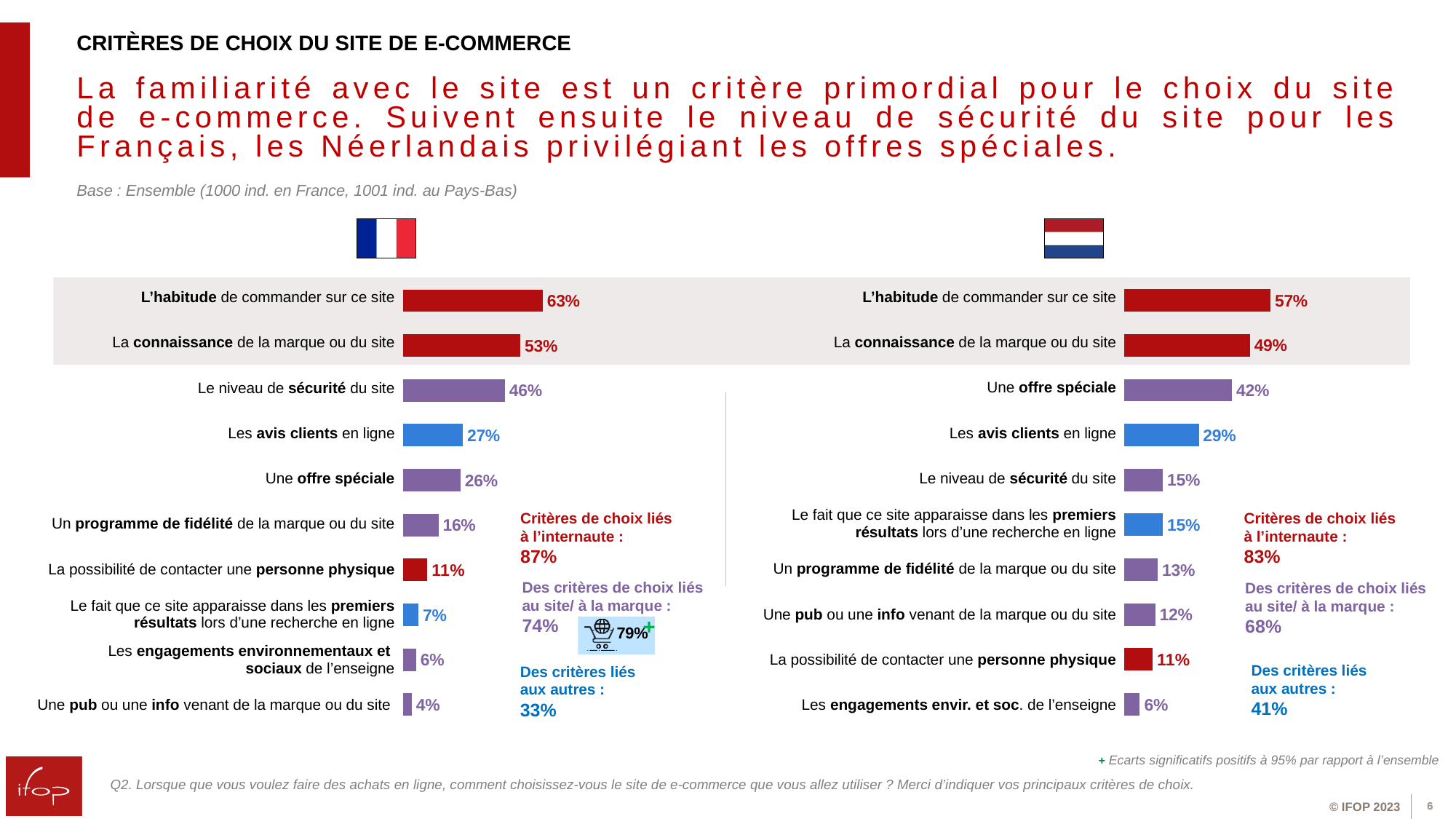
What type of chart is used on this slide? Bar chart In the left chart (France), what is the difference between "L'habitude de commander sur ce site" and "La connaissance de la marque ou du site"? 10% In the right chart (Pays-Bas), which criterion has the highest percentage? L'habitude de commander sur ce site How many criteria are listed in the right chart (Pays-Bas)? 10 In the right chart (Pays-Bas), what percentage is shown for "Une offre spéciale"? 42% Which is larger: "Les avis clients en ligne" in the left chart (France) or in the right chart (Pays-Bas)? Right chart (Pays-Bas), 29% In the left chart (France), what percentage is shown for "L'habitude de commander sur ce site"? 63% In the left chart (France), what percentage is shown for "Le niveau de sécurité du site"? 46% In the right chart (Pays-Bas), what percentage is shown for "Les engagements envir. et soc. de l'enseigne"? 6% In the right chart (Pays-Bas), what is the difference between "Une offre spéciale" and "Le niveau de sécurité du site"? 27% In the left chart (France), which criterion has the lowest percentage? Une pub ou une info venant de la marque ou du site How many criteria are listed in the left chart (France)? 10